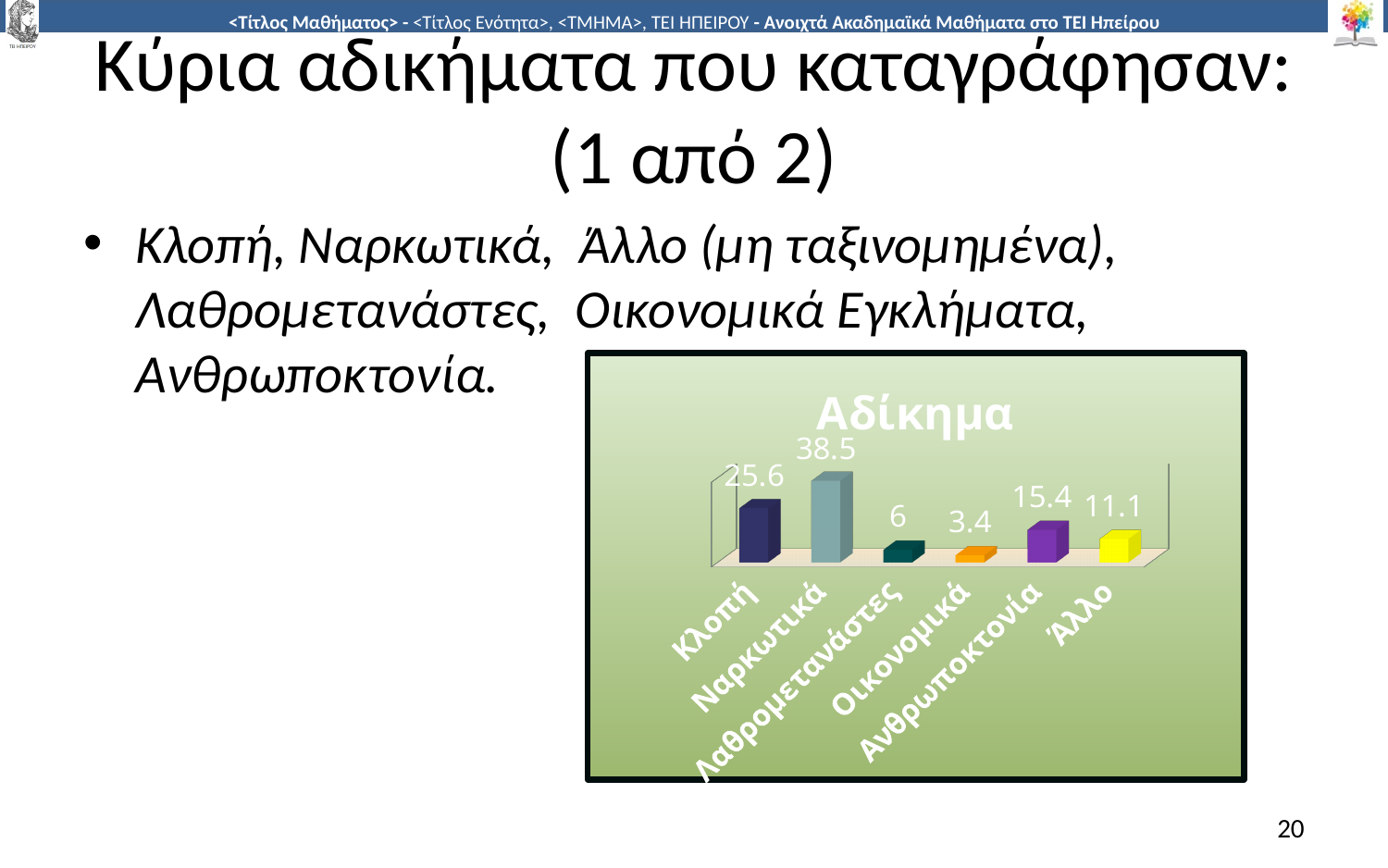
What is the value for Άλλο in the chart? 11.1 What is the value for Ναρκωτικά in the chart? 38.5 What is the title of the chart? Αδίκημα Which category has the lowest value in the chart? Οικονομικά What is the difference between the values for Ναρκωτικά and Κλοπή? 12.9 How many categories are shown in the chart? 6 What is the value for Οικονομικά in the chart? 3.4 Which is larger, the value for Ανθρωποκτονία or the value for Άλλο? Ανθρωποκτονία What is the value for Κλοπή in the chart? 25.6 What is the value for Ανθρωποκτονία in the chart? 15.4 What is the value for Λαθρομετανάστες in the chart? 6 Which category has the highest value in the chart? Ναρκωτικά